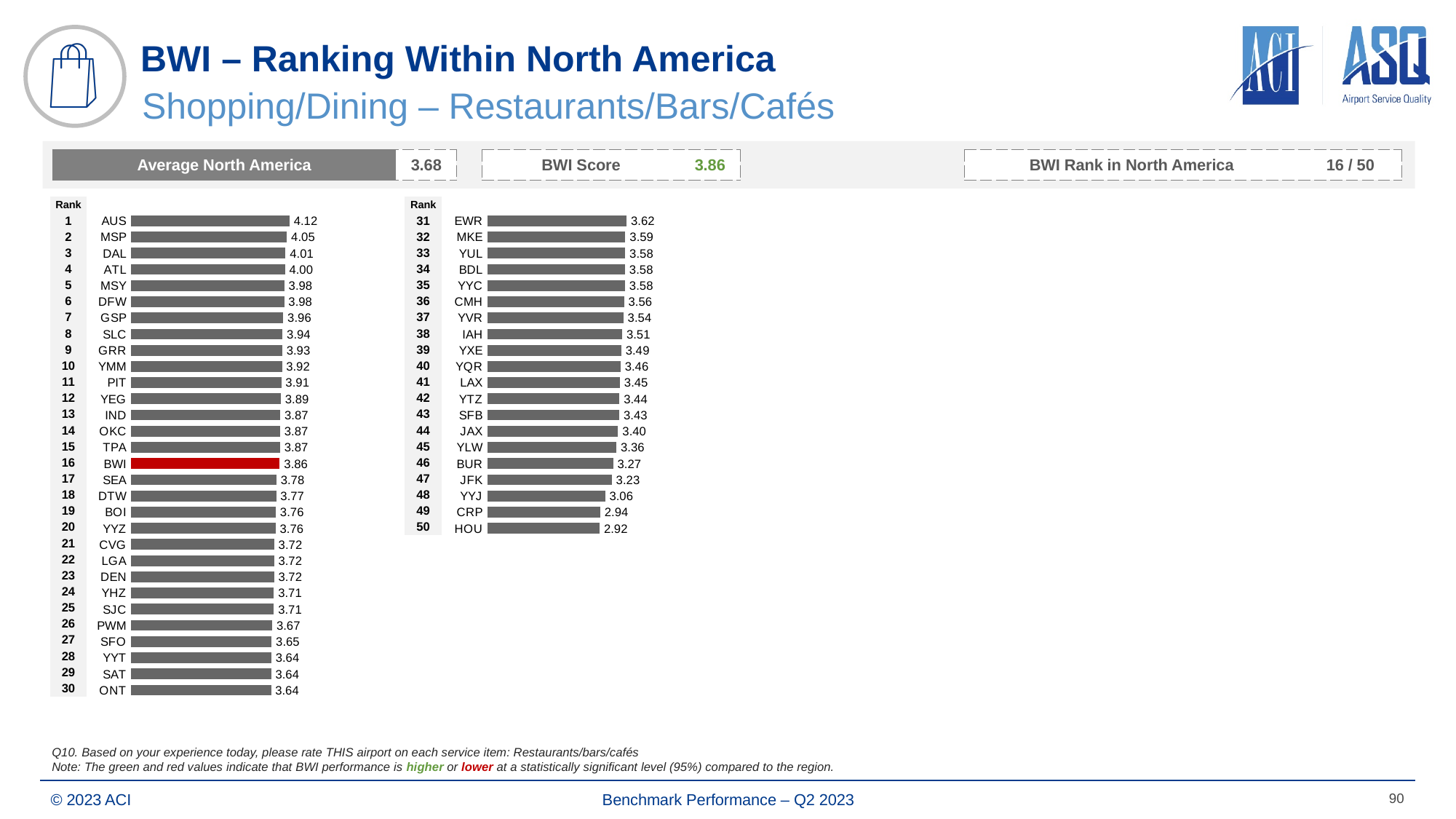
In the left chart (ranks 1-30), what is the difference between the values for AUS and BWI? 0.26 In the right chart (ranks 31-50), which airport has the lowest value? HOU What kind of chart is used to show the airport rankings on this slide? Bar chart How many airports are plotted in the left chart (ranks 1-30)? 30 In the right chart (ranks 31-50), what is the value for JFK? 3.23 In the left chart (ranks 1-30), what is the value for AUS? 4.12 In the left chart (ranks 1-30), which airport's bar is highlighted in red? BWI In the left chart (ranks 1-30), what is the value for BWI? 3.86 In the right chart (ranks 31-50), which airport has the highest value? EWR In the left chart (ranks 1-30), which airport has the highest value? AUS In the right chart (ranks 31-50), which has a larger value, LAX or BUR? LAX How many airports are plotted in the right chart (ranks 31-50)? 20